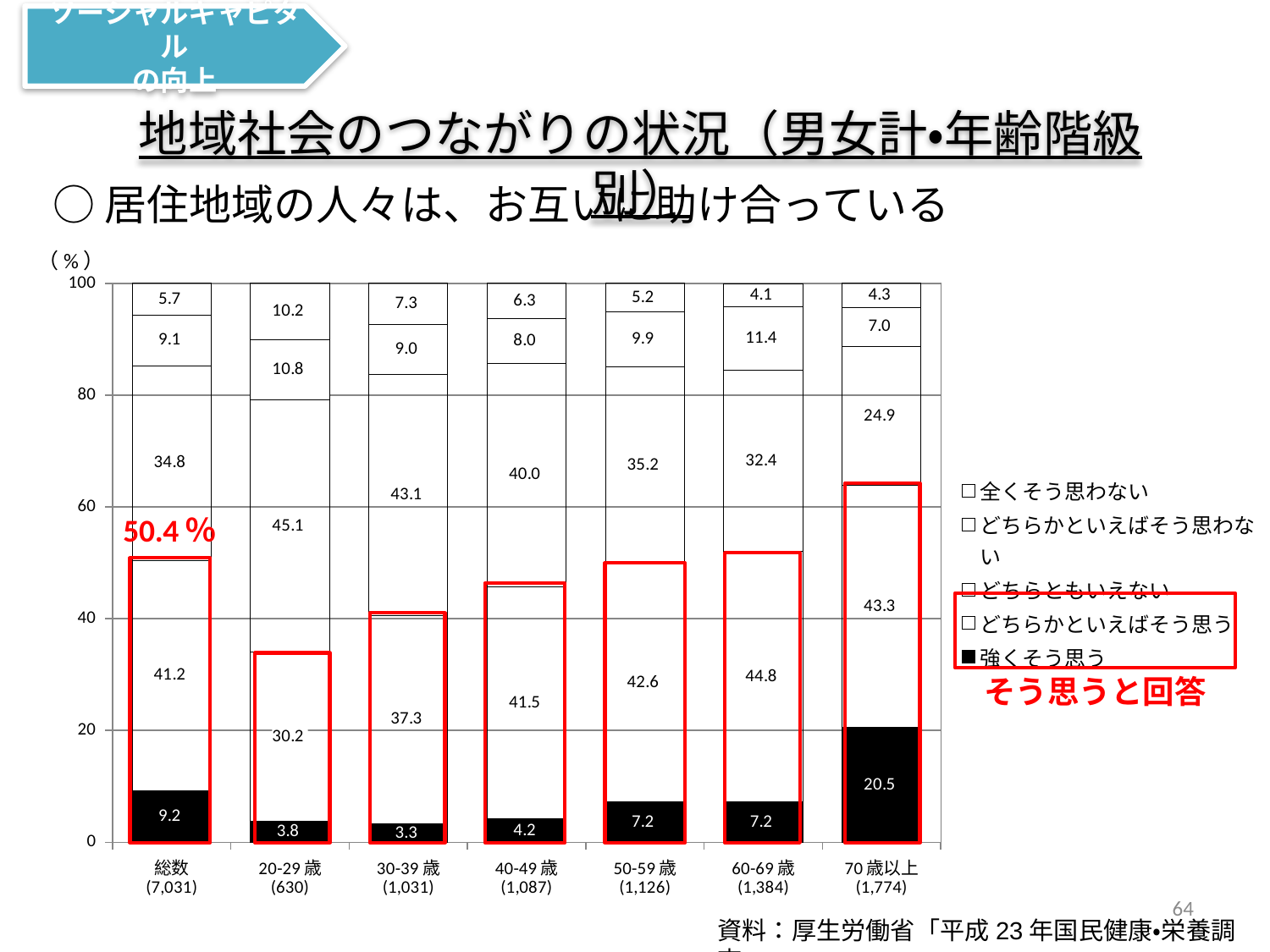
What kind of chart is shown on the slide? Stacked bar chart What is the value of どちらかといえばそう思う for 60-69歳? 44.8 What is the combined value of 強くそう思う and どちらかといえばそう思う for 総数? 50.4% What is the value of どちらともいえない for 20-29歳? 45.1 Which age group has the lowest value for 強くそう思う? 30-39歳 Which age group has the highest value for 強くそう思う? 70歳以上 What is the value of 全くそう思わない for 30-39歳? 7.3 How many series does the legend list? 5 What is the difference between the 強くそう思う value for 70歳以上 and for 総数? 11.3 How many categories are shown on the x axis? 7 Which is larger, the どちらともいえない value for 20-29歳 or for 70歳以上? 20-29歳 What is the value of 強くそう思う for 総数? 9.2